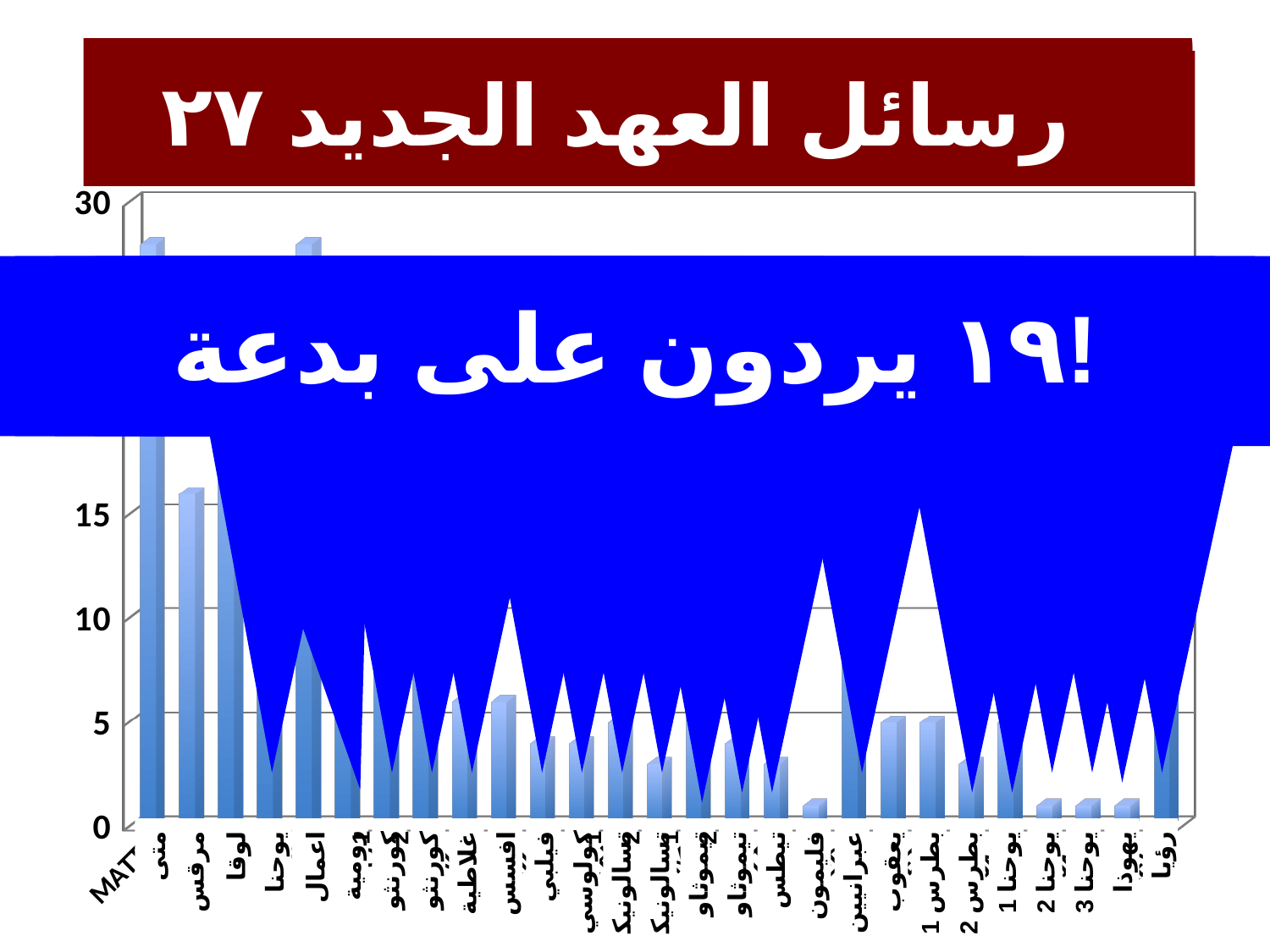
Is the value for يعقوب greater or less than 10? less How many categories (books) are shown along the x axis of the chart? 27 What is the title of the chart on the slide? رسائل العهد الجديد ٢٧ What kind of chart is shown on the slide? bar chart Is the value for فليمون greater or less than 5? less Is the value for اعمال greater or less than 15? greater What is the highest value shown on the y axis of the chart? 30 Which has the larger value, مرقس or فليمون? مرقس Which has the larger value, متى or مرقس? متى